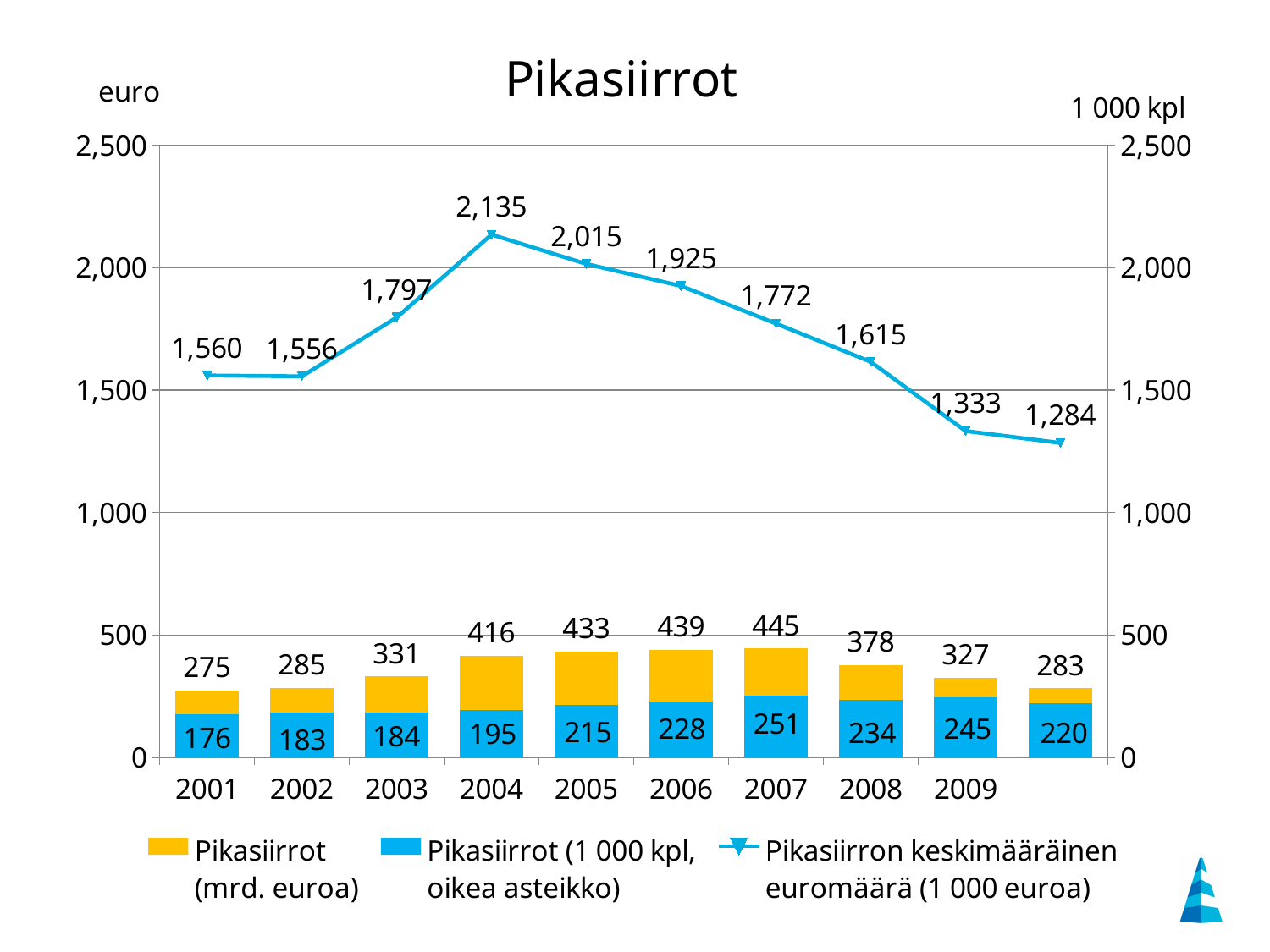
How many series does the legend list? 3 What is the difference between the Pikasiirrot (mrd. euroa) values for 2007 and 2001? 170 What is the value of the Pikasiirrot (mrd. euroa) bar for 2005? 433 What is the value of the Pikasiirron keskimääräinen euromäärä line for 2004? 2,135 By how much does the Pikasiirron keskimääräinen euromäärä line fall from 2004 to 2005? 120 In which year is the Pikasiirrot (1 000 kpl) bar lowest? 2001 In which year is the Pikasiirrot (mrd. euroa) bar highest? 2007 What is the value of the Pikasiirrot (1 000 kpl) bar for 2007? 251 Does the Pikasiirron keskimääräinen euromäärä line rise or fall from 2004 to 2009? fall Which year has the larger Pikasiirrot (1 000 kpl) value, 2008 or 2009? 2009 In which year does the Pikasiirron keskimääräinen euromäärä line reach its highest value? 2004 Is the Pikasiirron keskimääräinen euromäärä value for 2009 greater or less than 1,500? less